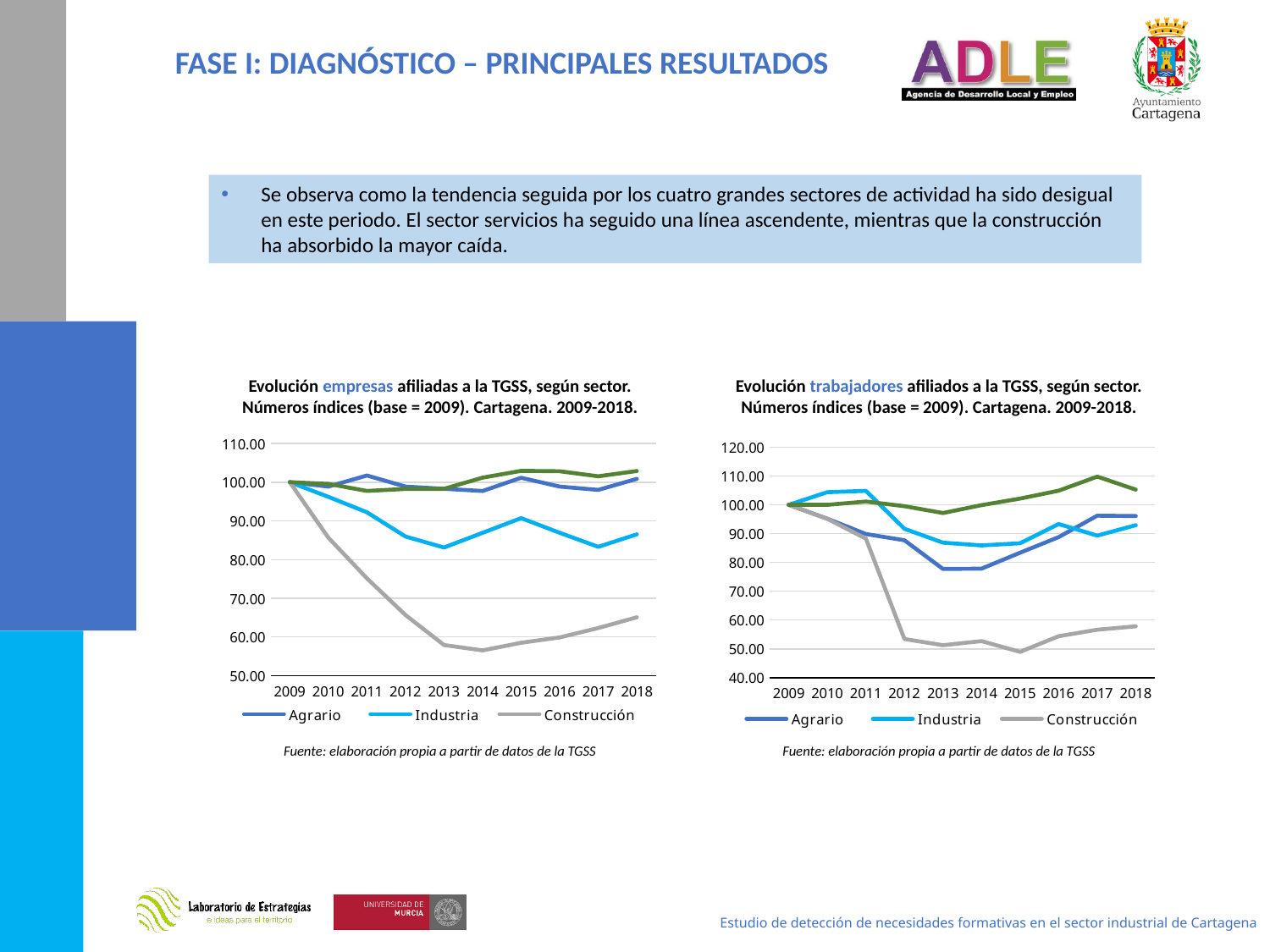
What is the source cited below the left chart, 'Evolución empresas afiliadas a la TGSS, según sector'? Fuente: elaboración propia a partir de datos de la TGSS What kind of chart is the left chart, 'Evolución empresas afiliadas a la TGSS, según sector'? line chart In the right chart, 'Evolución trabajadores afiliados a la TGSS, según sector', is the value for Agrario in 2013 greater or less than 80.00? less In the left chart, 'Evolución empresas afiliadas a la TGSS, según sector', which series has the lowest value in 2018? Construcción How many series does the legend of the right chart, 'Evolución trabajadores afiliados a la TGSS, según sector', list? 3 In the left chart, 'Evolución empresas afiliadas a la TGSS, según sector', is the value for Construcción in 2014 greater or less than 60.00? less In the right chart, 'Evolución trabajadores afiliados a la TGSS, según sector', which is larger in 2018, Industria or Construcción? Industria In the left chart, 'Evolución empresas afiliadas a la TGSS, según sector', does the Construcción line rise or fall from 2009 to 2014? fall How many years are shown on the x axis of the left chart, 'Evolución empresas afiliadas a la TGSS, según sector'? 10 In the left chart, 'Evolución empresas afiliadas a la TGSS, según sector', is the value for Industria in 2013 greater or less than 90.00? less In the left chart, 'Evolución empresas afiliadas a la TGSS, según sector', what is the value of Construcción in 2009? 100.00